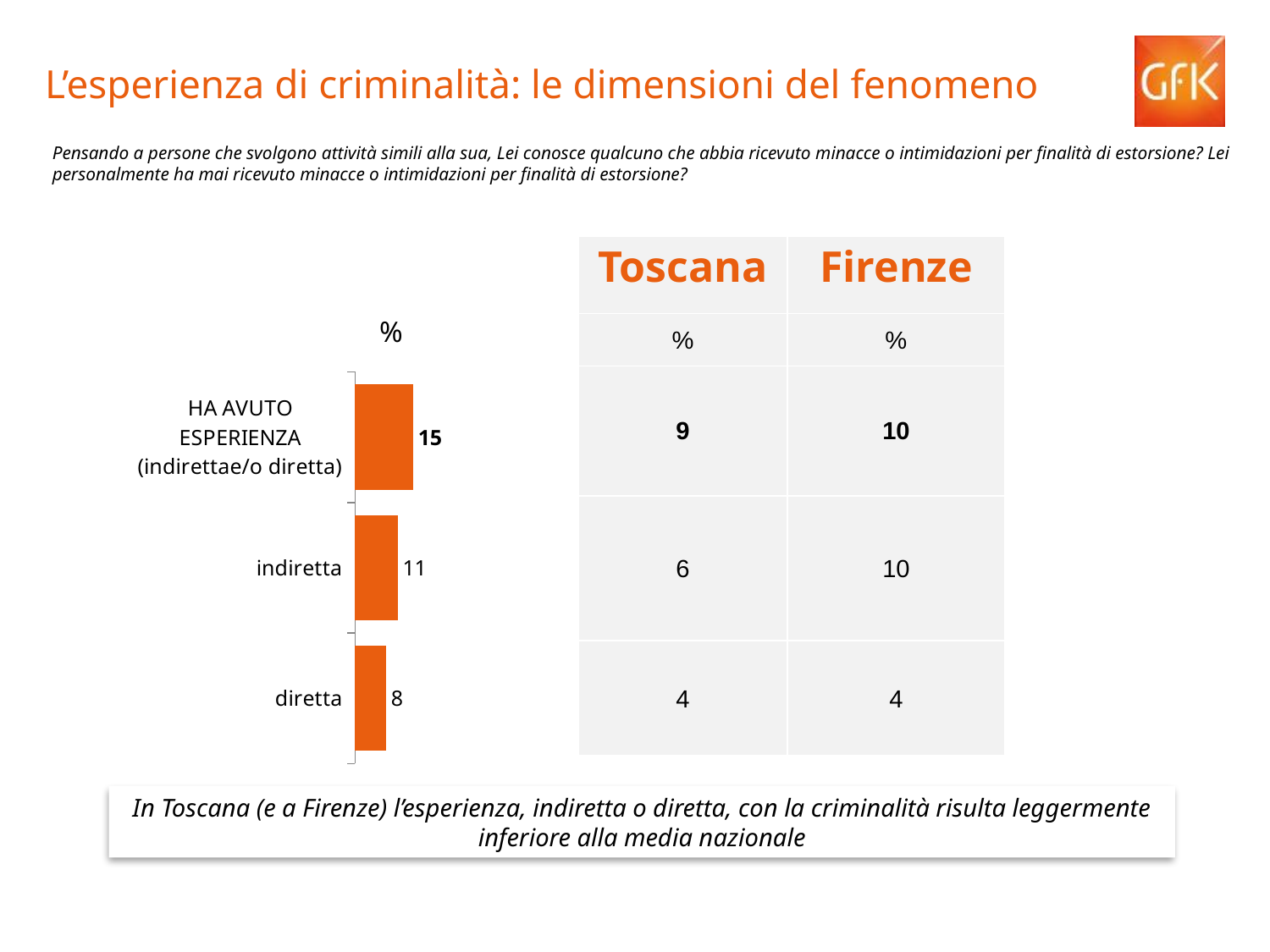
What is the difference between the values for "indiretta" and "diretta" in the bar chart? 3 Which category has the highest value in the bar chart? HA AVUTO ESPERIENZA (indiretta e/o diretta) What unit label is shown above the bars in the chart? % In the bar chart, which is larger: the value for "indiretta" or the value for "diretta"? indiretta What is the difference between the values for "HA AVUTO ESPERIENZA" and "indiretta" in the bar chart? 4 How many categories are shown in the bar chart? 3 What kind of chart is shown on the slide? bar chart What value does the bar chart show for "HA AVUTO ESPERIENZA (indiretta e/o diretta)"? 15 What value does the bar chart show for "indiretta"? 11 What colour are the bars in the chart? orange Which category has the lowest value in the bar chart? diretta What value does the bar chart show for "diretta"? 8